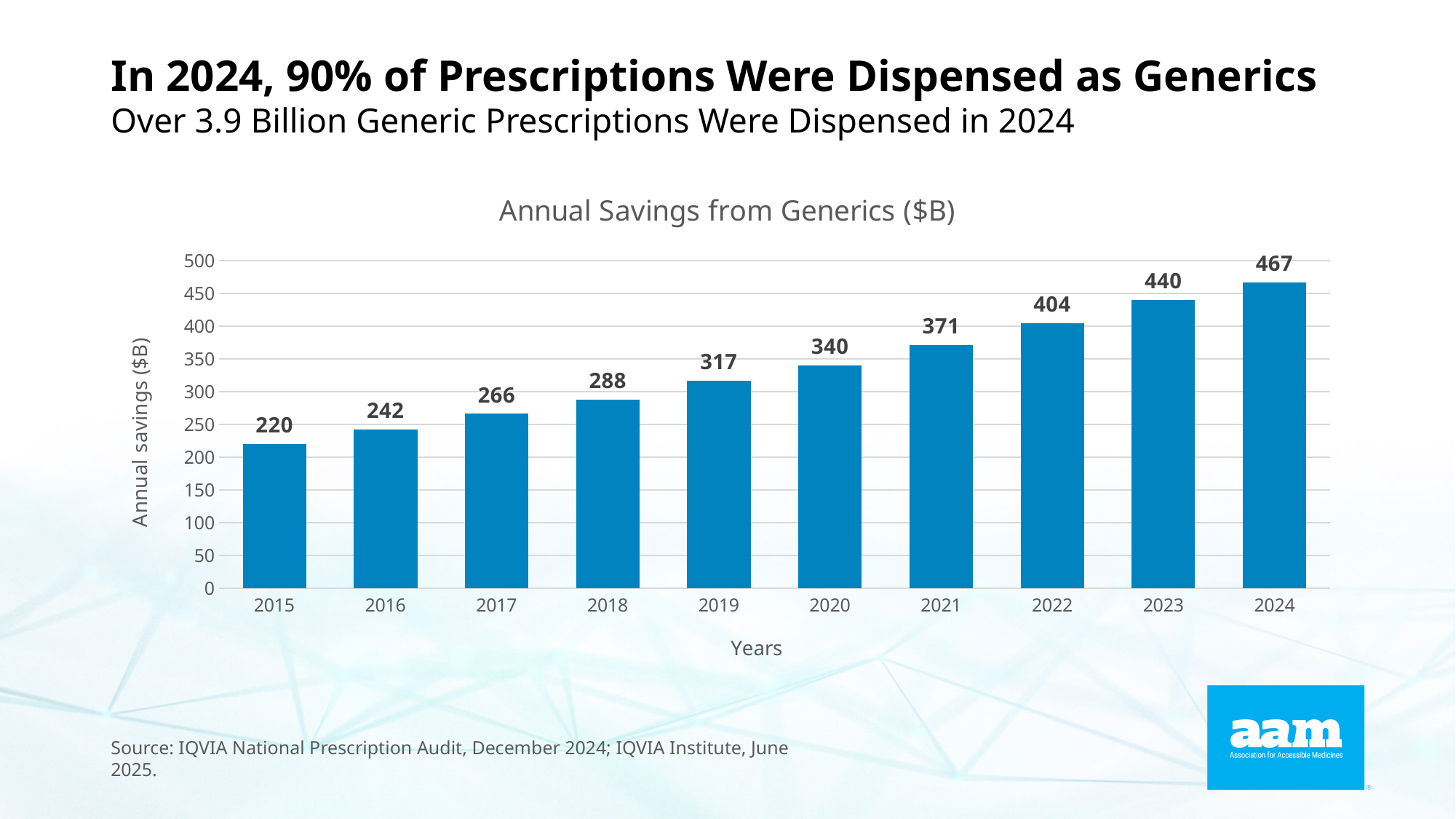
Is the value for 2022 greater or less than 400? greater What kind of chart is shown on the slide? Bar chart Which year has the lowest annual savings from generics? 2015 Which year has larger annual savings, 2018 or 2021? 2021 How many years are shown on the chart? 10 What is the annual savings from generics for 2024? 467 Do annual savings from generics rise or fall from 2015 to 2024? Rise Which year has the highest annual savings from generics? 2024 What is the difference in annual savings between 2024 and 2023? 27 What is the annual savings from generics for 2019? 317 What is the difference in annual savings between 2020 and 2015? 120 What is the annual savings from generics for 2015? 220